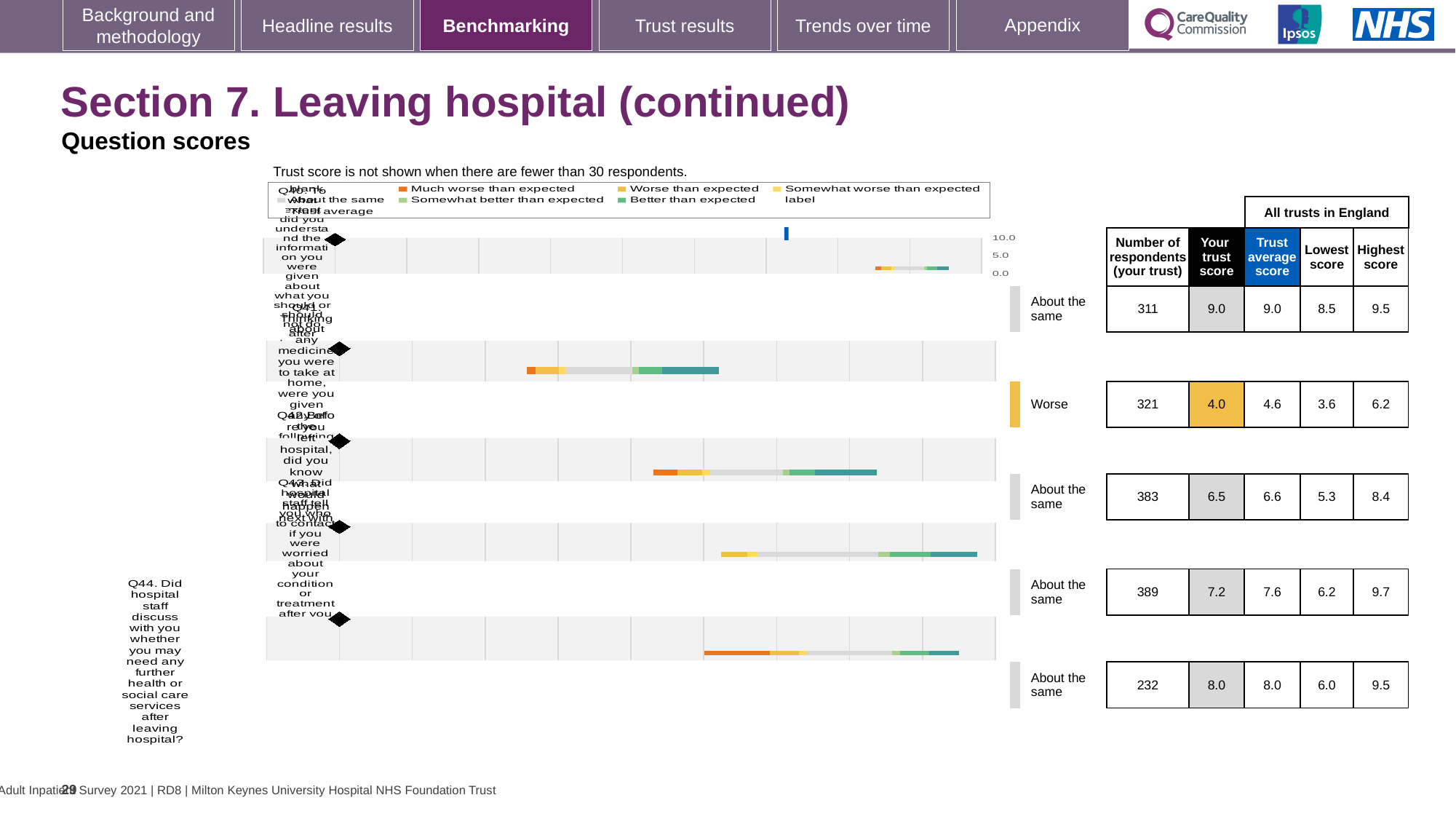
In the table, what is the 'Trust average score' for the row with 321 respondents? 4.6 For the row with 389 respondents, is 'Your trust score' higher or lower than the 'Trust average score'? lower What is the highest 'Your trust score' shown in the table? 9.0 How many question rows are shown in the benchmarking chart and table? 5 In the table, what is the difference between the 'Trust average score' and 'Your trust score' for the row rated 'Worse'? 0.6 In the table, how many respondents are shown for the row rated 'Worse'? 321 In the table, what is the 'Your trust score' for the bottom row (Q44, about discussing further health or social care services after leaving hospital)? 8.0 What is the lowest 'Your trust score' shown in the table? 4.0 In the table, what is the difference between the 'Highest score' and the 'Lowest score' for the row with 383 respondents? 3.1 In the table, what is the 'Highest score' for the top row (311 respondents)? 9.5 How many of the rows are rated 'Worse' rather than 'About the same'? 1 What kind of chart is used to show the benchmarking results on this slide? bar chart